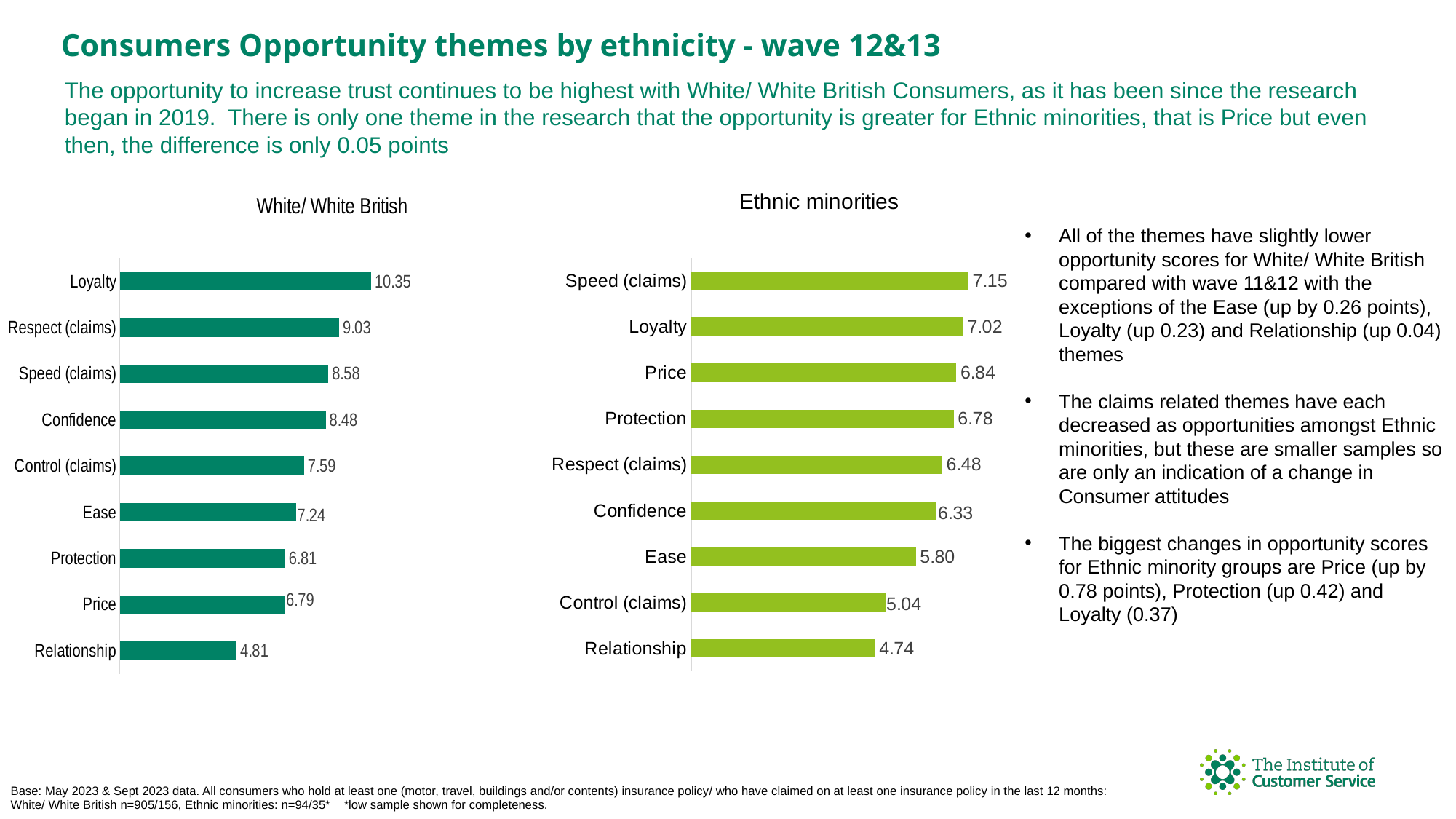
In the White/ White British chart, what is the value for Loyalty? 10.35 In the Ethnic minorities chart, which theme has the highest value? Speed (claims) What is the title of the chart on the left? White/ White British In the Ethnic minorities chart, what is the value for Speed (claims)? 7.15 How many themes are shown in the White/ White British chart? 9 In the White/ White British chart, what is the difference between Loyalty and Respect (claims)? 1.32 In the Ethnic minorities chart, which is larger: Ease or Control (claims)? Ease In the White/ White British chart, what is the value for Control (claims)? 7.59 Which is larger: Price in the White/ White British chart or Price in the Ethnic minorities chart? Ethnic minorities What type of chart is the Ethnic minorities chart? Bar chart In the White/ White British chart, which theme has the lowest value? Relationship In the Ethnic minorities chart, what is the difference between Loyalty and Relationship? 2.28